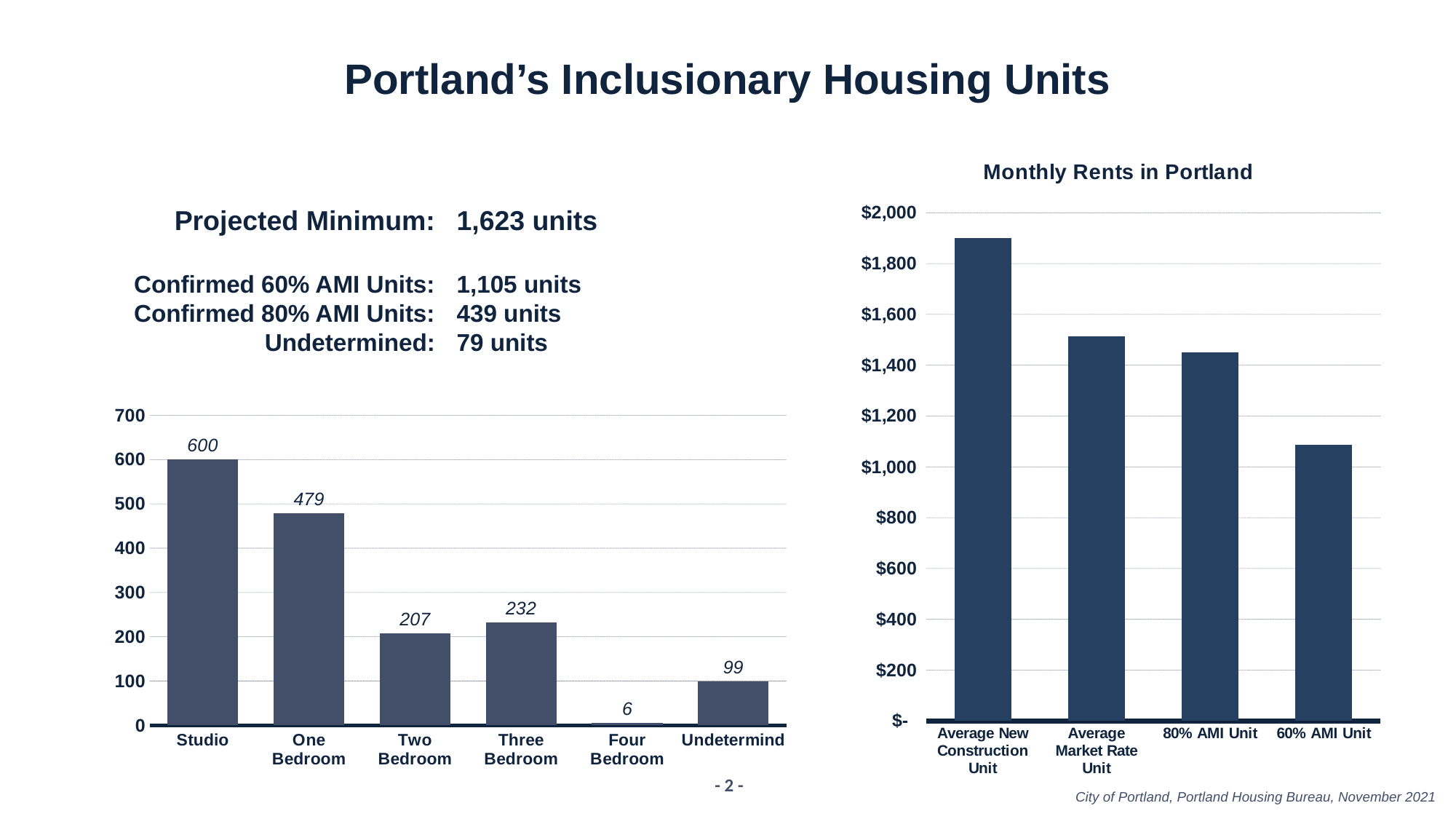
How many categories are shown in the left bar chart? 6 In the left bar chart, which is larger, Two Bedroom or Three Bedroom? Three Bedroom In the left bar chart, what is the difference between the Studio and One Bedroom values? 121 In the left bar chart, what is the value for Two Bedroom? 207 In the Monthly Rents in Portland chart, is the value for 60% AMI Unit greater or less than $1,200? less In the Monthly Rents in Portland chart, is the value for Average New Construction Unit greater or less than $1,800? greater In the Monthly Rents in Portland chart, which category has the lowest monthly rent? 60% AMI Unit What kind of chart is the Monthly Rents in Portland chart? Bar chart In the left bar chart, which category has the lowest value? Four Bedroom In the left bar chart, how many units are shown for Studio? 600 In the left bar chart, which category has the highest value? Studio What is the title of the chart on the right side of the slide? Monthly Rents in Portland